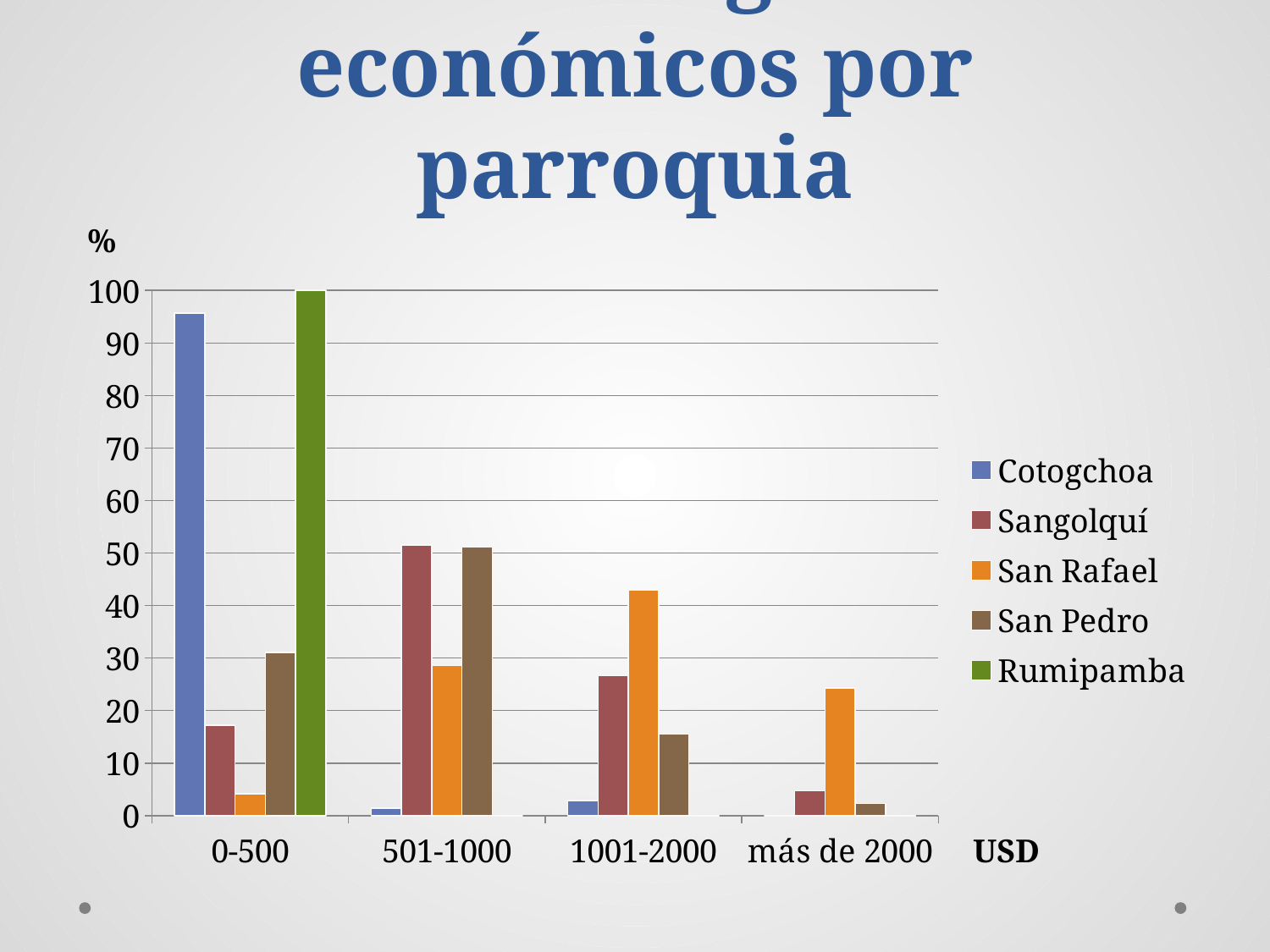
What kind of chart is shown on the slide? bar chart How many income ranges are shown on the x axis? 4 Which parroquia has the lowest value in the 0-500 range? San Rafael How many series does the legend list? 5 In the 501-1000 range, which is larger: Sangolquí or San Rafael? Sangolquí Is the value for San Pedro in the 1001-2000 range greater or less than 20? less What is the value for Rumipamba in the 0-500 range? 100 Which parroquia has the highest value in the más de 2000 range? San Rafael Which parroquia has the highest value in the 0-500 range? Rumipamba Is the value for San Rafael in the 1001-2000 range greater or less than 30? greater Do the values for Rumipamba rise or fall from the 0-500 range to the más de 2000 range? fall Is the value for Cotogchoa in the 0-500 range greater or less than 90? greater